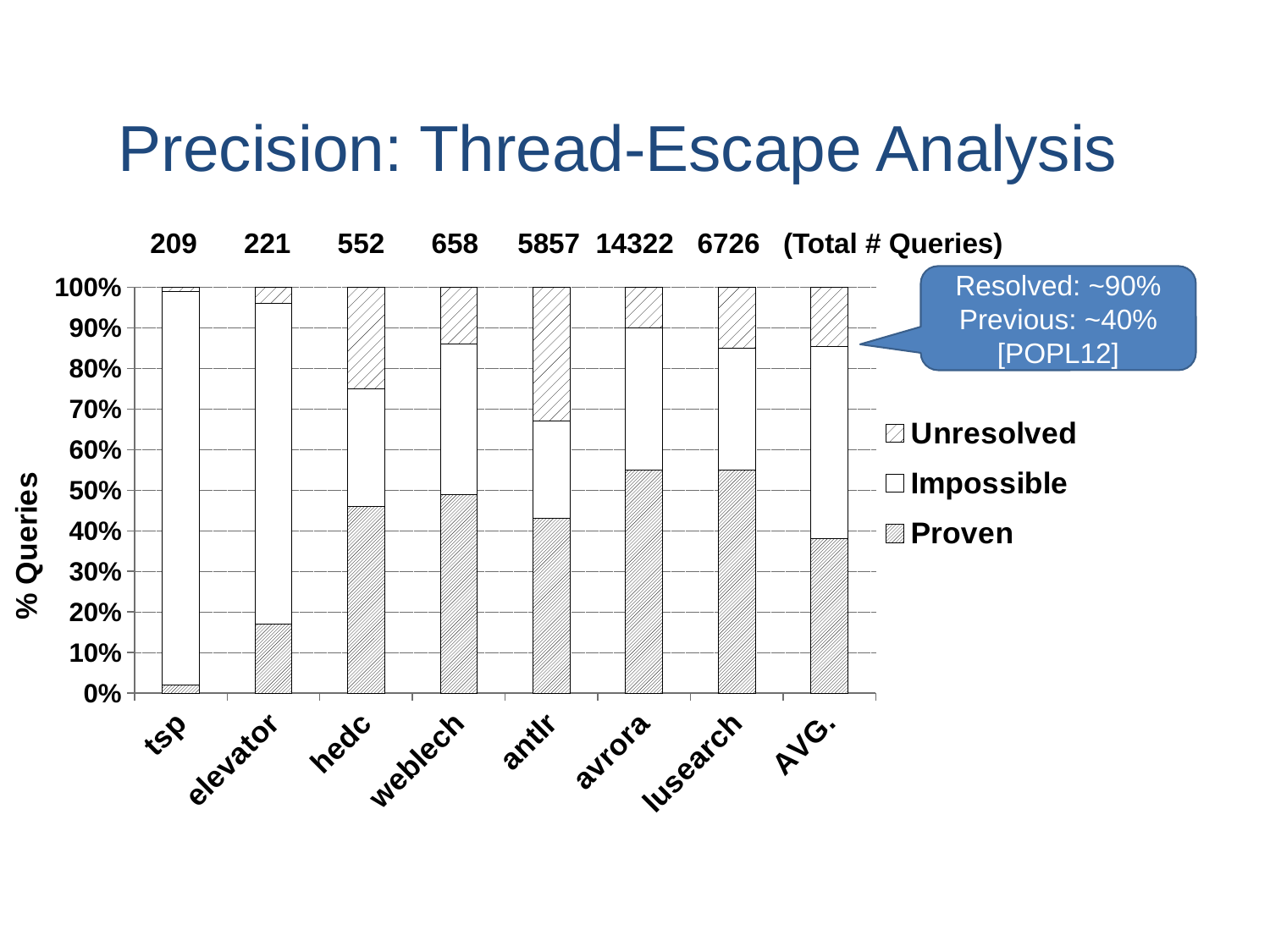
What total number of queries is printed above the avrora bar? 14322 Which category has the lowest Proven share? tsp Is the Proven value for tsp greater or less than 10%? less What kind of chart is shown on the slide? stacked bar chart Is the Proven value for AVG. greater or less than 40%? less Which is larger, the Impossible share for tsp or for elevator? tsp What is the total height of the stacked bar for hedc? 100% How many categories are shown along the x axis of the chart? 8 What is the label on the y axis of the chart? % Queries How many series does the chart's legend list? 3 Is the Proven value for avrora greater or less than 50%? greater Which category has the highest Unresolved share? antlr